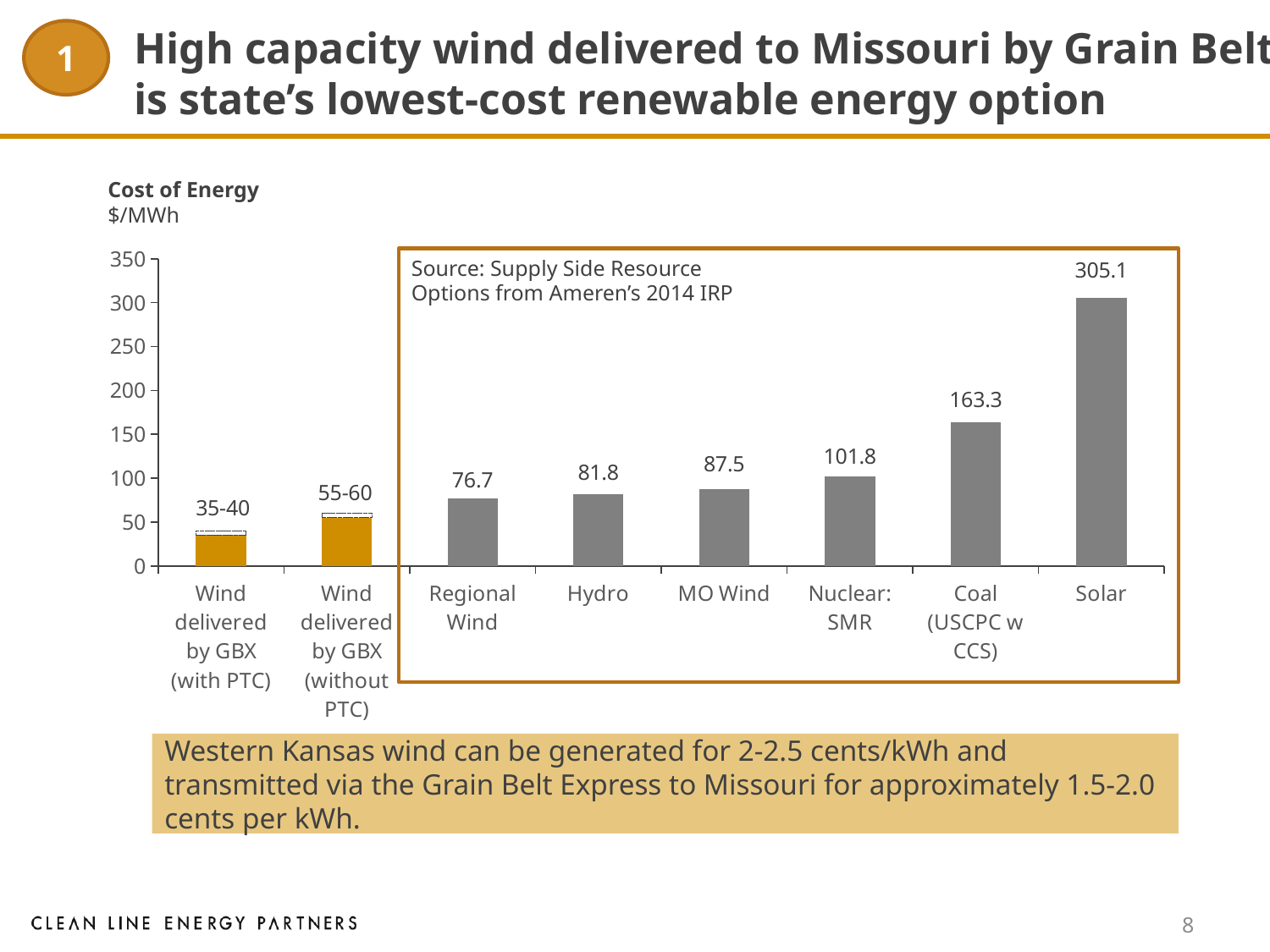
What is the cost of energy for Solar in $/MWh? 305.1 What is the difference in cost of energy between Solar and Coal (USCPC w CCS)? 141.8 Is the value for Nuclear: SMR greater or less than 100? greater What is the cost of energy for Coal (USCPC w CCS)? 163.3 Which category has the lowest cost of energy? Wind delivered by GBX (with PTC) Which category has the highest cost of energy? Solar What is the difference in cost of energy between Nuclear: SMR and Regional Wind? 25.1 Which has a higher cost of energy, MO Wind or Hydro? MO Wind What value is shown for Wind delivered by GBX (with PTC)? 35-40 How many categories are shown on the x axis of the chart? 8 What is the cost of energy for Hydro? 81.8 What kind of chart is shown on the slide? Bar chart